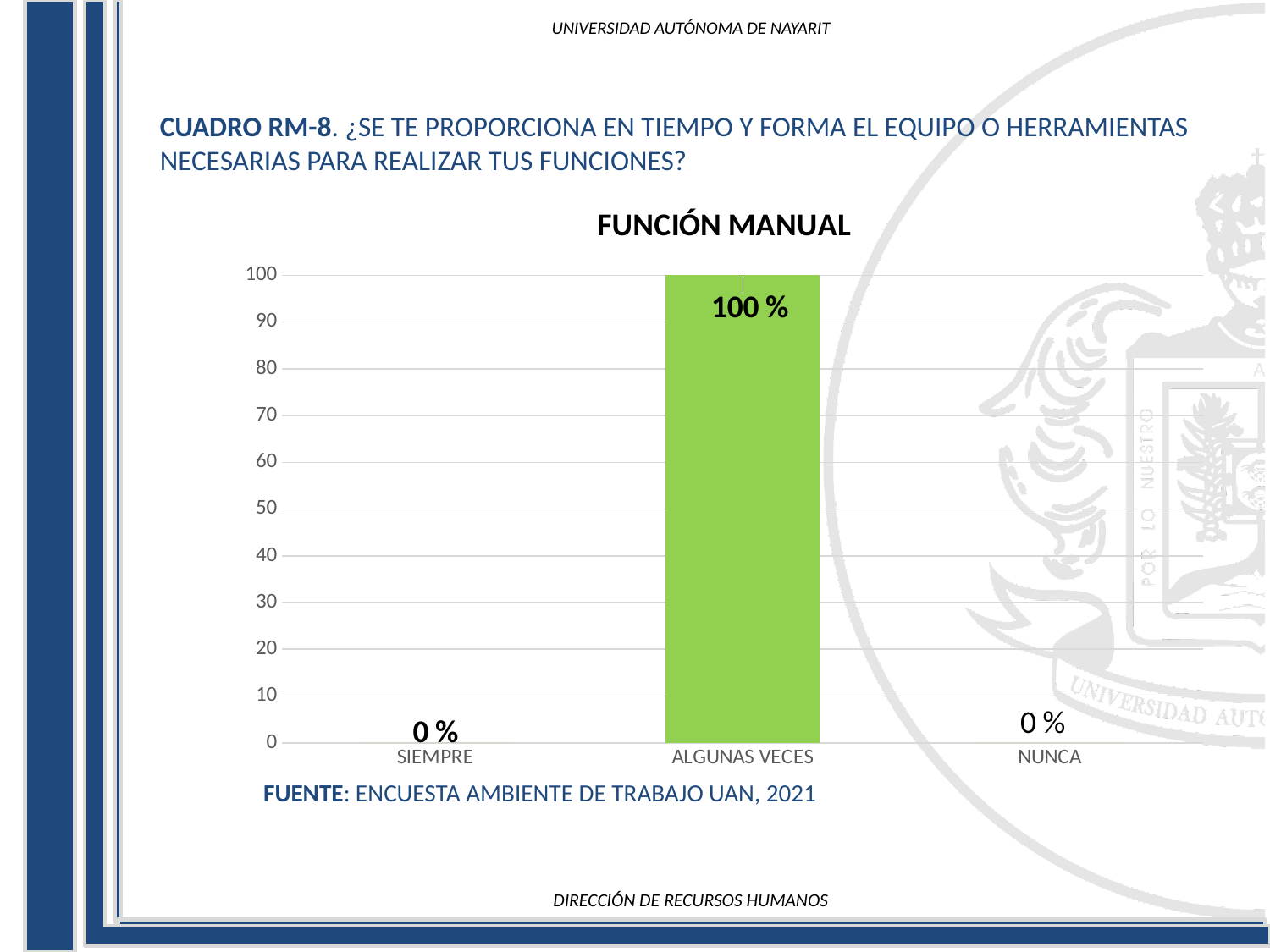
Which is larger, the value for ALGUNAS VECES or the value for NUNCA? ALGUNAS VECES What is the total of the values for SIEMPRE and NUNCA? 0 % What is the title of the chart? FUNCIÓN MANUAL What is the value for ALGUNAS VECES? 100 % What kind of chart is shown on the slide? bar chart What is the value for NUNCA? 0 % Which category has the highest value? ALGUNAS VECES Is the value for ALGUNAS VECES greater or less than 50? greater How many categories are shown on the x axis? 3 What is the highest value shown on the vertical axis? 100 What is the difference between the values for ALGUNAS VECES and SIEMPRE? 100 % What is the value for SIEMPRE? 0 %